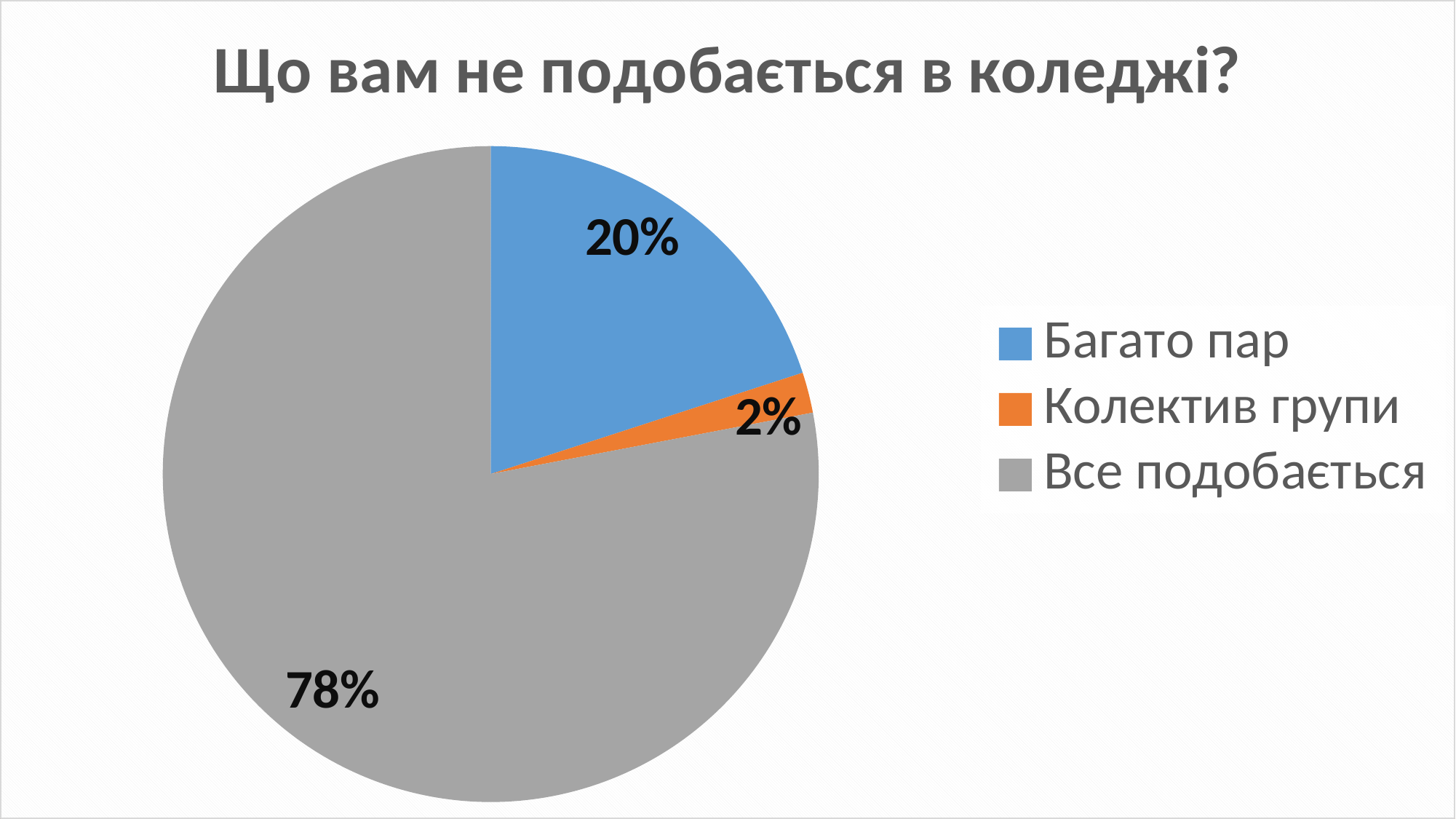
What is the title of the chart? Що вам не подобається в коледжі? Which is larger, the slice for "Багато пар" or the slice for "Колектив групи"? Багато пар What share of the pie does "Все подобається" take? 78% How many categories does the legend list? 3 Which category has the largest slice? Все подобається What share of the pie does "Багато пар" take? 20% What is the difference in percentage points between "Багато пар" and "Колектив групи"? 18 What colour is the slice for "Колектив групи"? orange What share of the pie does "Колектив групи" take? 2% What type of chart is shown on the slide? pie chart What is the difference in percentage points between "Все подобається" and "Багато пар"? 58 Which category has the smallest slice? Колектив групи